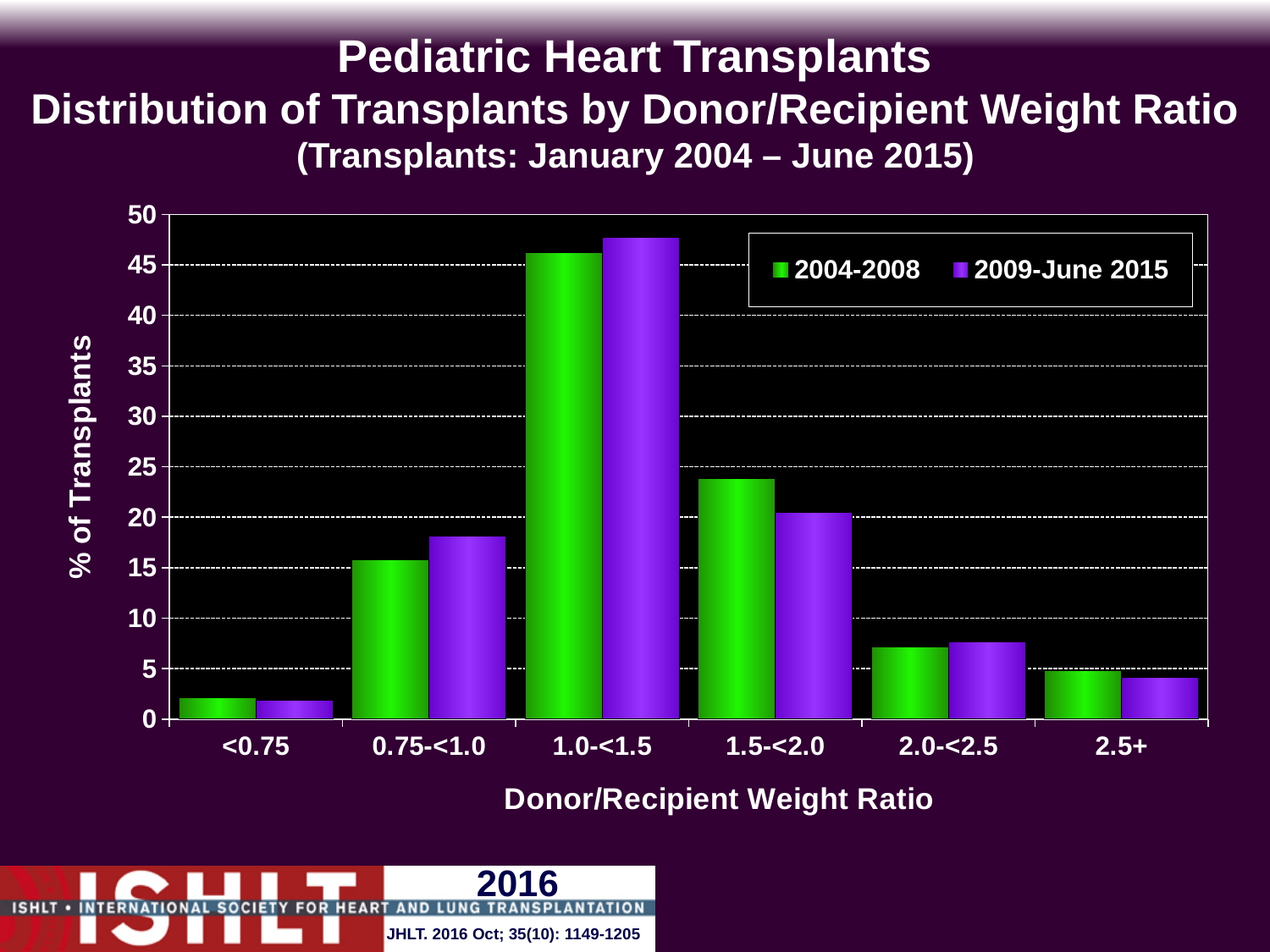
Is the value for 2004-2008 in the 1.0-<1.5 category greater or less than 40? greater Which weight ratio category has the highest % of transplants for 2004-2008? 1.0-<1.5 Which weight ratio category has the lowest % of transplants for 2009-June 2015? <0.75 How many series does the legend list? 2 How many donor/recipient weight ratio categories are shown on the x axis? 6 Is the value for 2009-June 2015 in the 0.75-<1.0 category greater or less than 20? less What is the label of the y axis? % of Transplants For the 1.5-<2.0 category, which series has the larger value, 2004-2008 or 2009-June 2015? 2004-2008 Is the value for 2009-June 2015 in the 2.5+ category greater or less than 5? less For the 0.75-<1.0 category, which series has the larger value, 2004-2008 or 2009-June 2015? 2009-June 2015 What type of chart is shown on the slide? bar chart